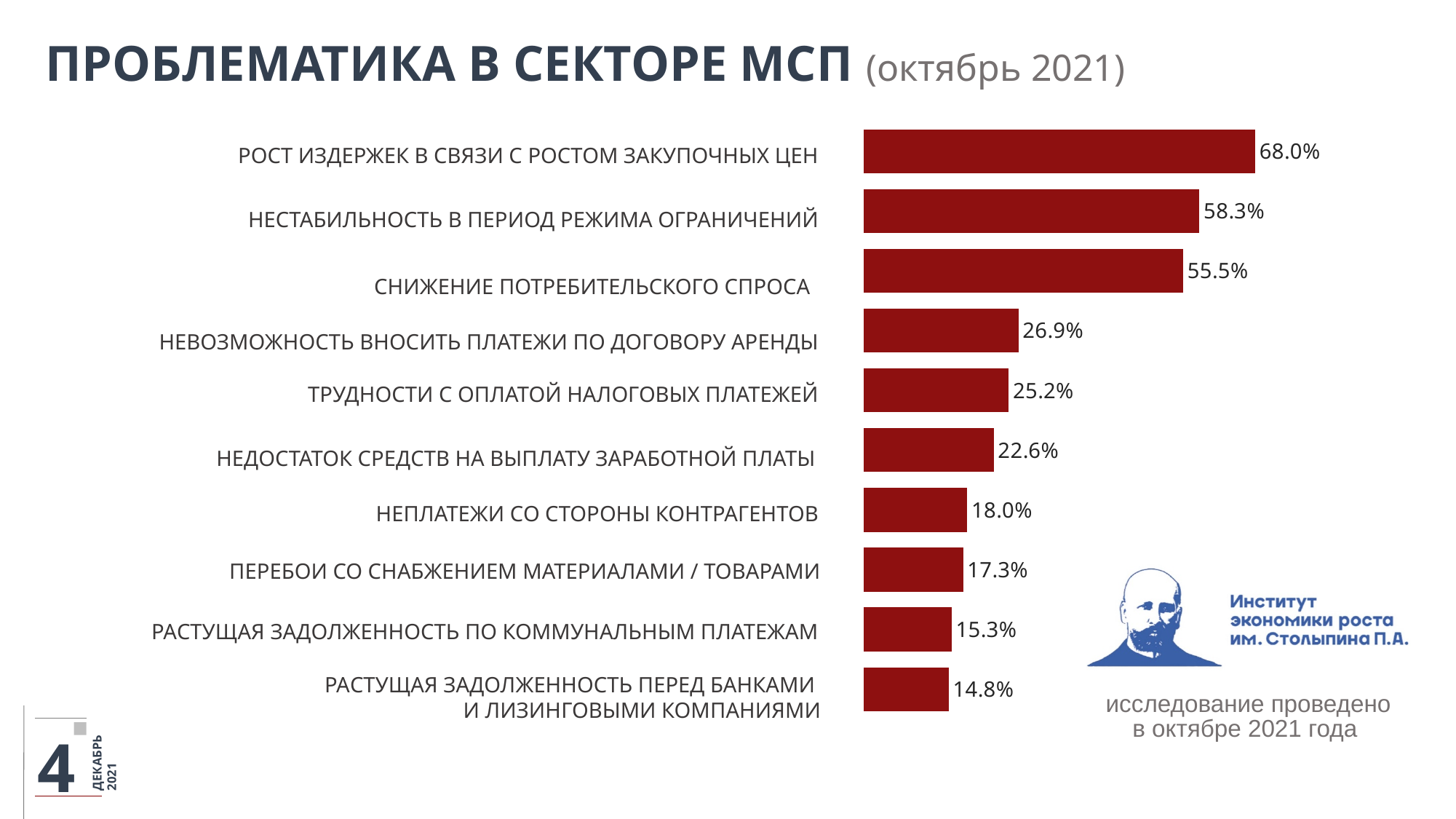
What is the value for «Снижение потребительского спроса»? 55.5% What is the value for «Рост издержек в связи с ростом закупочных цен»? 68.0% What is the difference between the values for «Невозможность вносить платежи по договору аренды» and «Трудности с оплатой налоговых платежей»? 1.7 percentage points Which category has the lowest value? Растущая задолженность перед банками и лизинговыми компаниями Which category has the highest value? Рост издержек в связи с ростом закупочных цен What is the title of the slide containing the chart? ПРОБЛЕМАТИКА В СЕКТОРЕ МСП (октябрь 2021) What is the value for «Неплатежи со стороны контрагентов»? 18.0% Which is larger: the value for «Недостаток средств на выплату заработной платы» or for «Перебои со снабжением материалами / товарами»? Недостаток средств на выплату заработной платы What is the value for «Растущая задолженность по коммунальным платежам»? 15.3% What is the difference between the values for «Рост издержек в связи с ростом закупочных цен» and «Нестабильность в период режима ограничений»? 9.7 percentage points How many categories (problems) are shown in the chart? 10 What kind of chart is shown on the slide? Bar chart